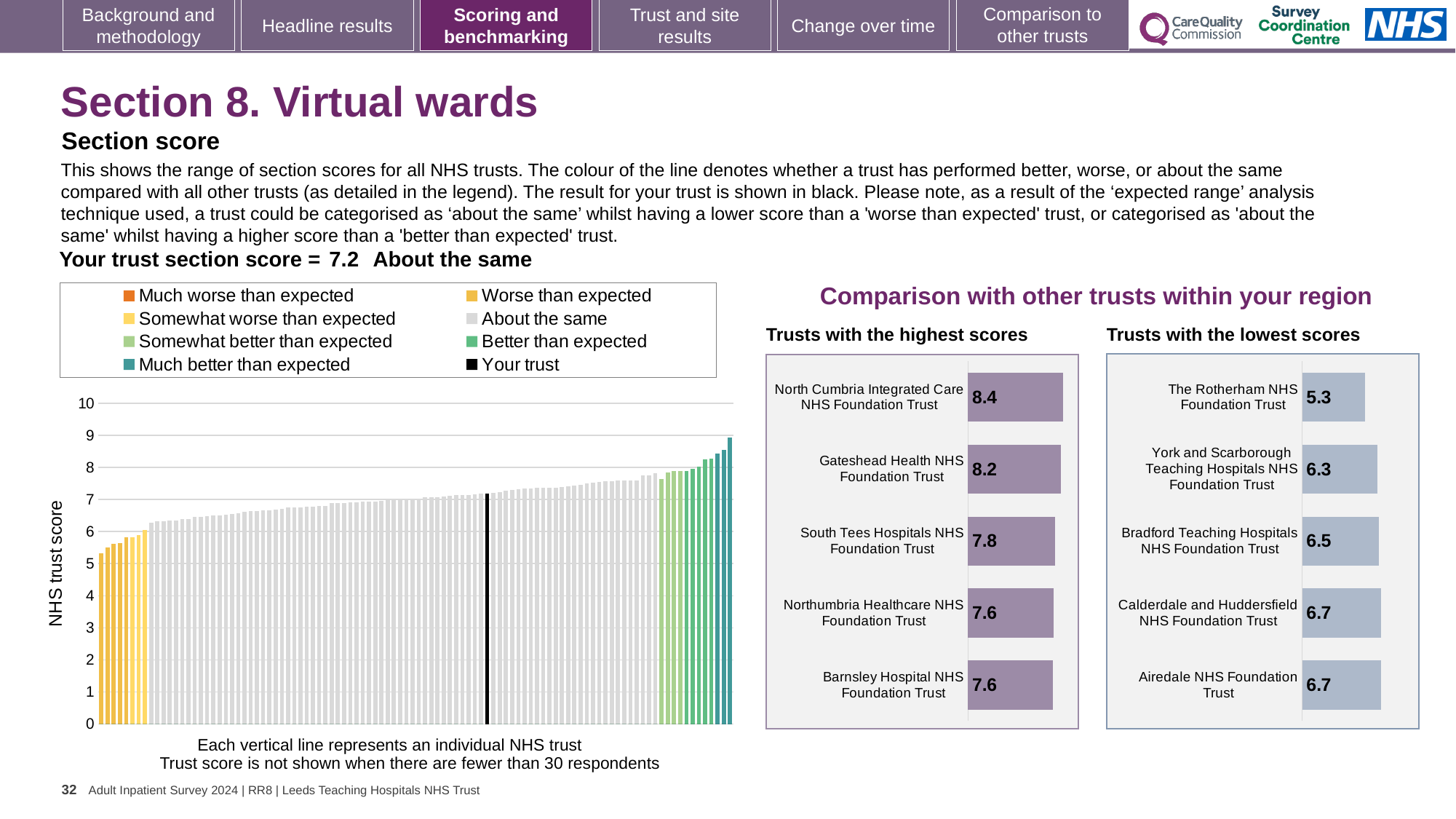
In the 'Trusts with the lowest scores' chart, what is the difference between the scores of Bradford Teaching Hospitals NHS Foundation Trust and The Rotherham NHS Foundation Trust? 1.2 In the 'Trusts with the highest scores' chart, what is the difference between the scores of North Cumbria Integrated Care NHS Foundation Trust and South Tees Hospitals NHS Foundation Trust? 0.6 In the 'Trusts with the lowest scores' chart, which trust has the lowest score? The Rotherham NHS Foundation Trust What is the section score for your trust shown in the NHS trust score chart on the left? 7.2 In the 'Trusts with the highest scores' chart, what is the score for North Cumbria Integrated Care NHS Foundation Trust? 8.4 In the NHS trust score chart on the left, is the value of the tallest bar greater or less than 8? greater How many trusts are listed in the 'Trusts with the highest scores' chart? 5 How many entries does the legend of the NHS trust score chart on the left list? 8 In the NHS trust score chart on the left, do the bar values rise or fall from left to right? rise In the 'Trusts with the lowest scores' chart, which has the higher score: York and Scarborough Teaching Hospitals NHS Foundation Trust or Calderdale and Huddersfield NHS Foundation Trust? Calderdale and Huddersfield NHS Foundation Trust In the 'Trusts with the highest scores' chart, which trust has the lowest score shown? Northumbria Healthcare NHS Foundation Trust and Barnsley Hospital NHS Foundation Trust (7.6) In the 'Trusts with the lowest scores' chart, what is the score for The Rotherham NHS Foundation Trust? 5.3